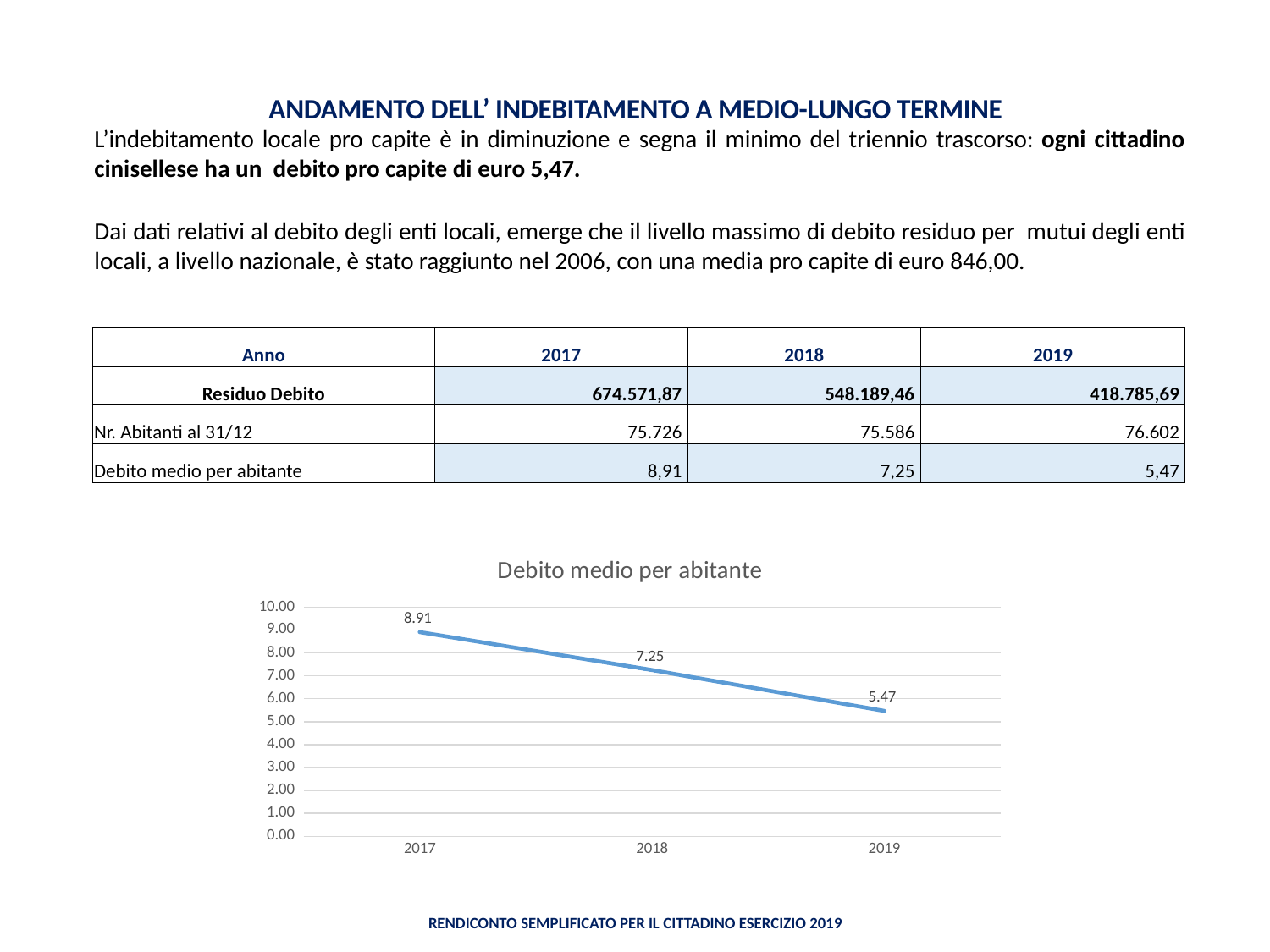
Do the values rise or fall from 2017 to 2019? fall Is the value for 2018 greater or less than 8.00? less How many years are plotted in the chart? 3 Which year has the highest value in the chart? 2017 What is the value for 2019 in the chart? 5.47 What kind of chart is shown on the slide? line chart What is the value for 2017 in the chart? 8.91 What is the difference between the values for 2017 and 2018? 1.66 Which is larger, the value for 2018 or the value for 2019? 2018 Which year has the lowest value in the chart? 2019 What is the difference between the values for 2017 and 2019? 3.44 What is the value for 2018 in the chart? 7.25